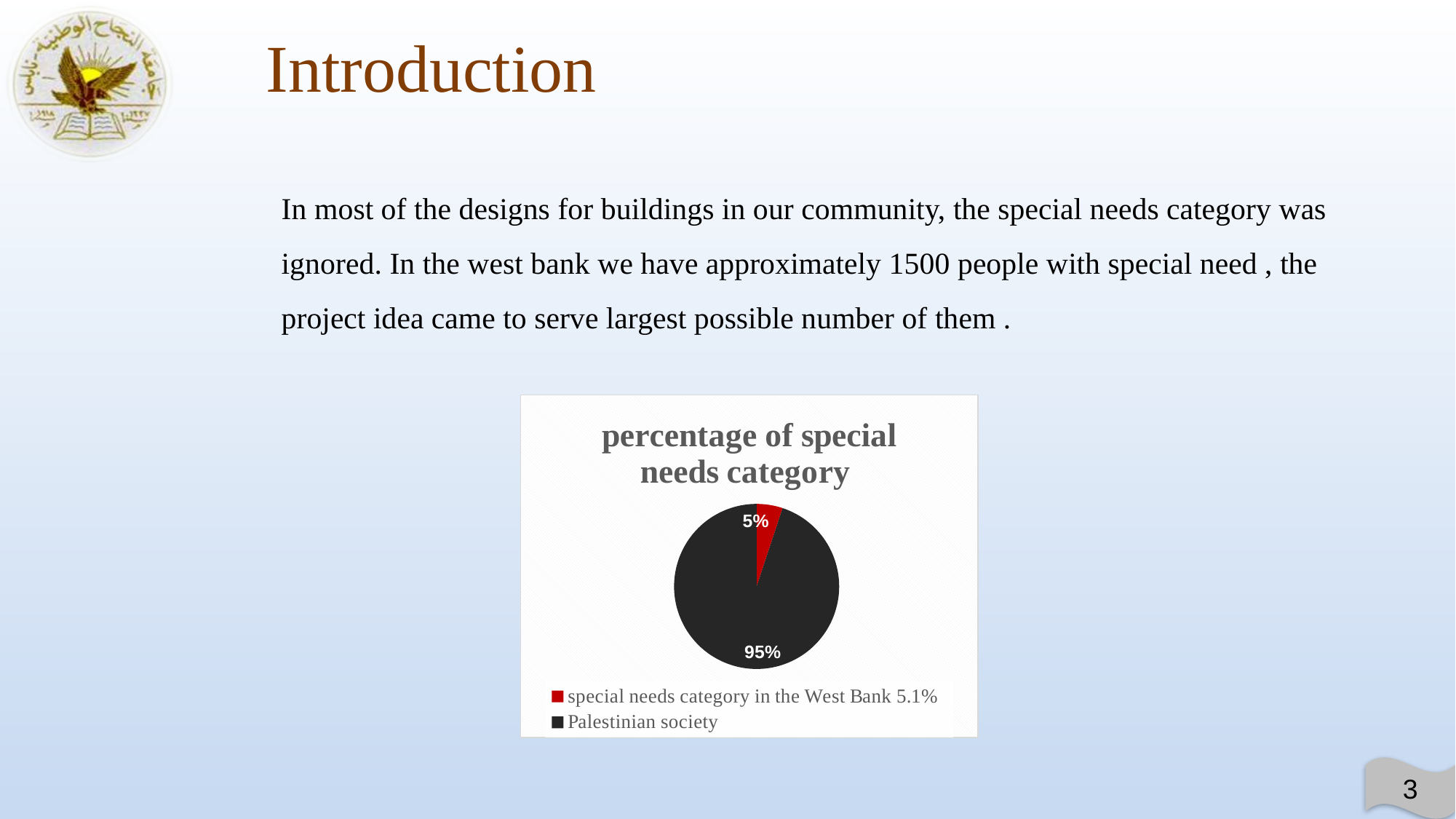
What share of the pie does the 'Palestinian society' slice represent? 95% How many entries does the legend list? 2 What share of the pie does the 'special needs category in the West Bank 5.1%' slice represent? 5% What is the title of the chart? percentage of special needs category Which slice of the pie is the smallest? special needs category in the West Bank 5.1% Which is larger: the 'Palestinian society' slice or the 'special needs category in the West Bank 5.1%' slice? Palestinian society Which slice of the pie is the largest? Palestinian society What is the difference in percentage points between the 'Palestinian society' slice and the 'special needs category in the West Bank 5.1%' slice? 90% How many slices does the pie chart have? 2 What kind of chart is shown on the slide? pie chart What colour is the 'special needs category in the West Bank 5.1%' slice? red